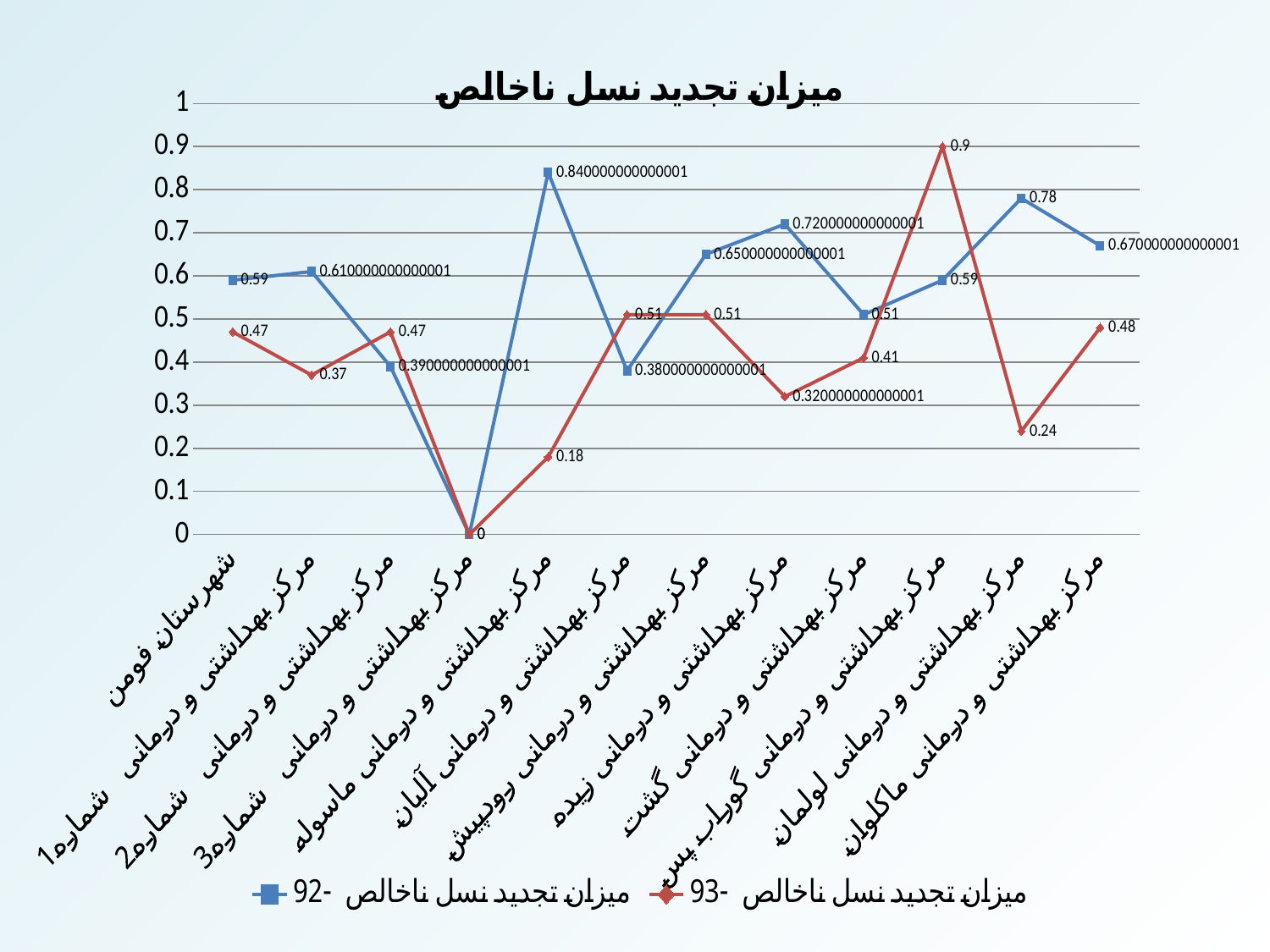
How many categories are plotted along the x axis? 12 For 'مرکز بهداشتی و درمانی آلیان', which series has the larger value, 92 or 93? میزان تجدید نسل ناخالص -93 What is the value of the series 'میزان تجدید نسل ناخالص -93' for 'مرکز بهداشتی و درمانی ماکلوان'? 0.48 What is the title of the chart? میزان تجدید نسل ناخالص Which category has the highest value in the series 'میزان تجدید نسل ناخالص -92'? مرکز بهداشتی و درمانی ماسوله Which category has the highest value in the series 'میزان تجدید نسل ناخالص -93'? مرکز بهداشتی و درمانی گوراب پس What kind of chart is shown on the slide? line chart What is the value of the series 'میزان تجدید نسل ناخالص -92' for 'شهرستان فومن'? 0.59 What is the value of the series 'میزان تجدید نسل ناخالص -93' for 'مرکز بهداشتی و درمانی ماسوله'? 0.18 Which category has the lowest value in the series 'میزان تجدید نسل ناخالص -92'? مرکز بهداشتی و درمانی شماره3 How many series does the legend list? 2 What is the difference between the 92 and 93 series values for 'مرکز بهداشتی و درمانی لولمان'? 0.54